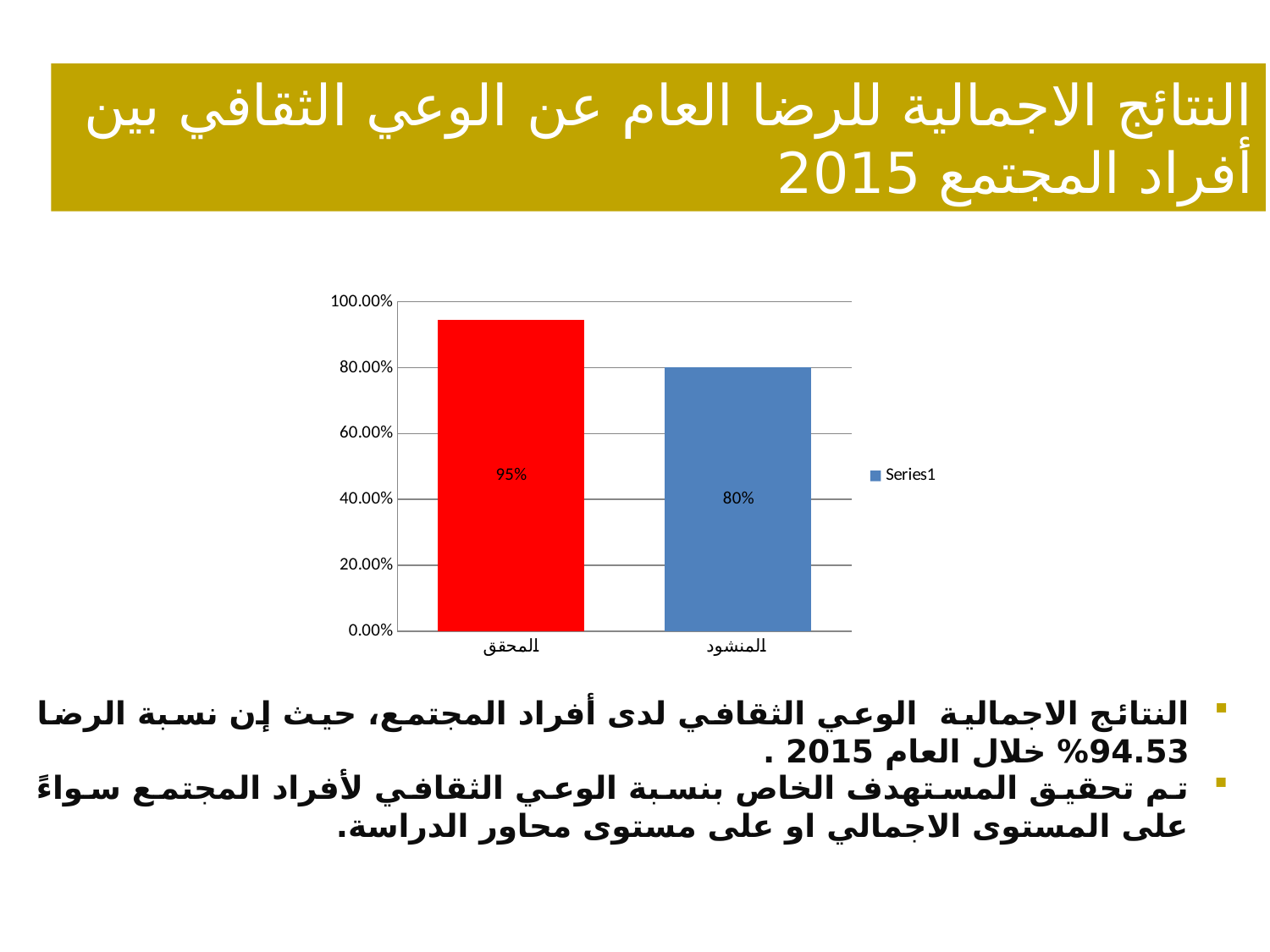
Which category has the lowest value? المنشود Is the value for المحقق greater or less than 100.00%? less How many categories are shown on the x axis? 2 Is the value for المنشود greater or less than 60.00%? greater What value is shown for المنشود? 80% What is the name of the series listed in the legend? Series1 How many series does the legend list? 1 Which category has the highest value? المحقق What kind of chart is shown on the slide? bar chart What value is shown for المحقق? 95% What is the difference between the values for المحقق and المنشود? 15% Which is larger, the value for المحقق or the value for المنشود? المحقق